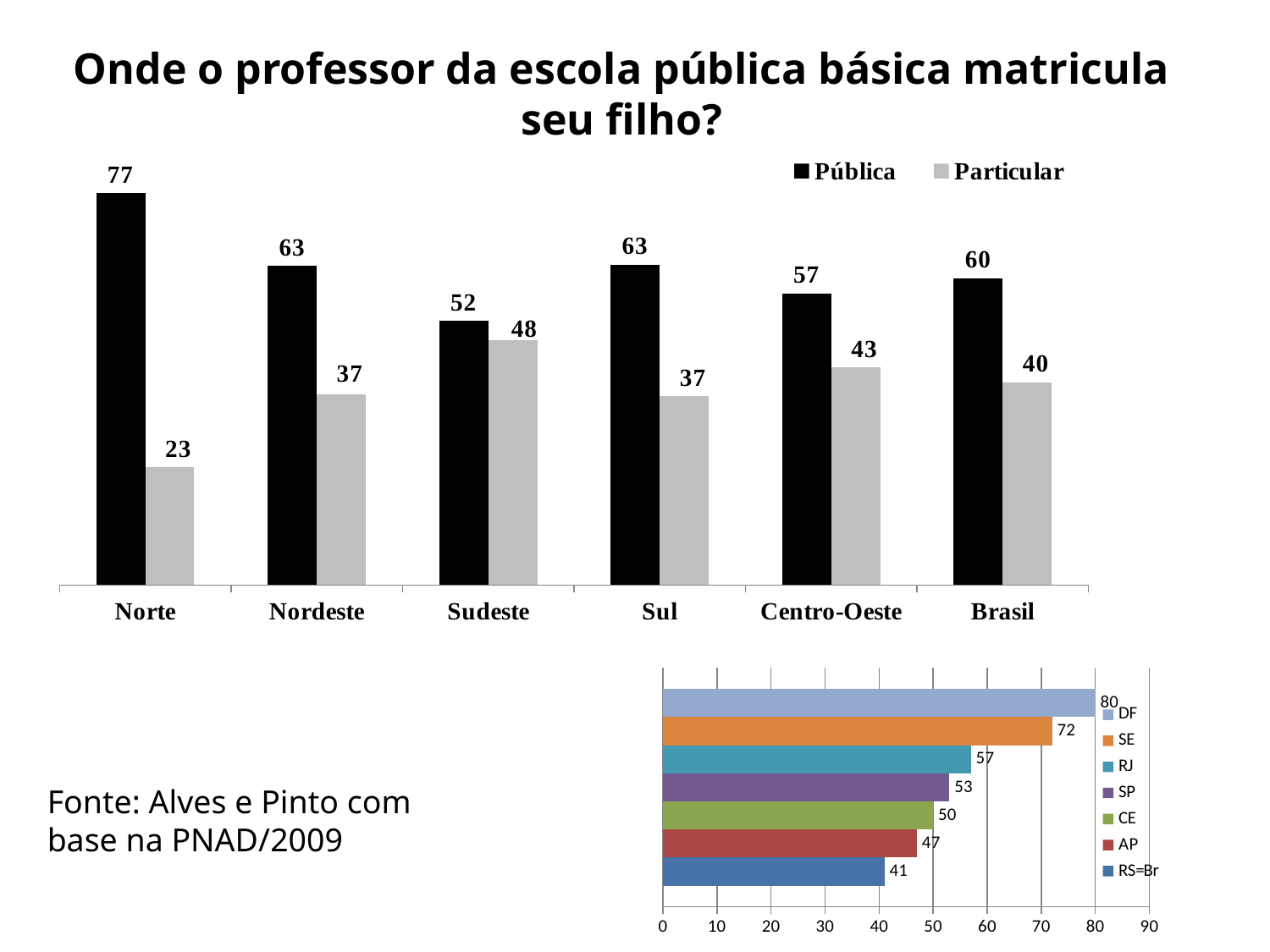
In the top chart, how many categories are shown on the x axis? 6 In the top chart, is the Pública value for Centro-Oeste larger or smaller than the Pública value for Sul? smaller In the top chart, how many series does the legend list? 2 What kind of chart is the bottom chart? bar chart In the bottom chart, what is the value for SE? 72 In the bottom chart, what is the difference between the values for DF and RS=Br? 39 In the top chart, what is the difference between the Pública and Particular values for Brasil? 20 In the bottom chart, which entry has the highest value? DF In the top chart, which region has the highest Pública value? Norte In the top chart, what is the Particular value for Sudeste? 48 In the top chart, what is the Pública value for Norte? 77 In the top chart, which region has the lowest Particular value? Norte